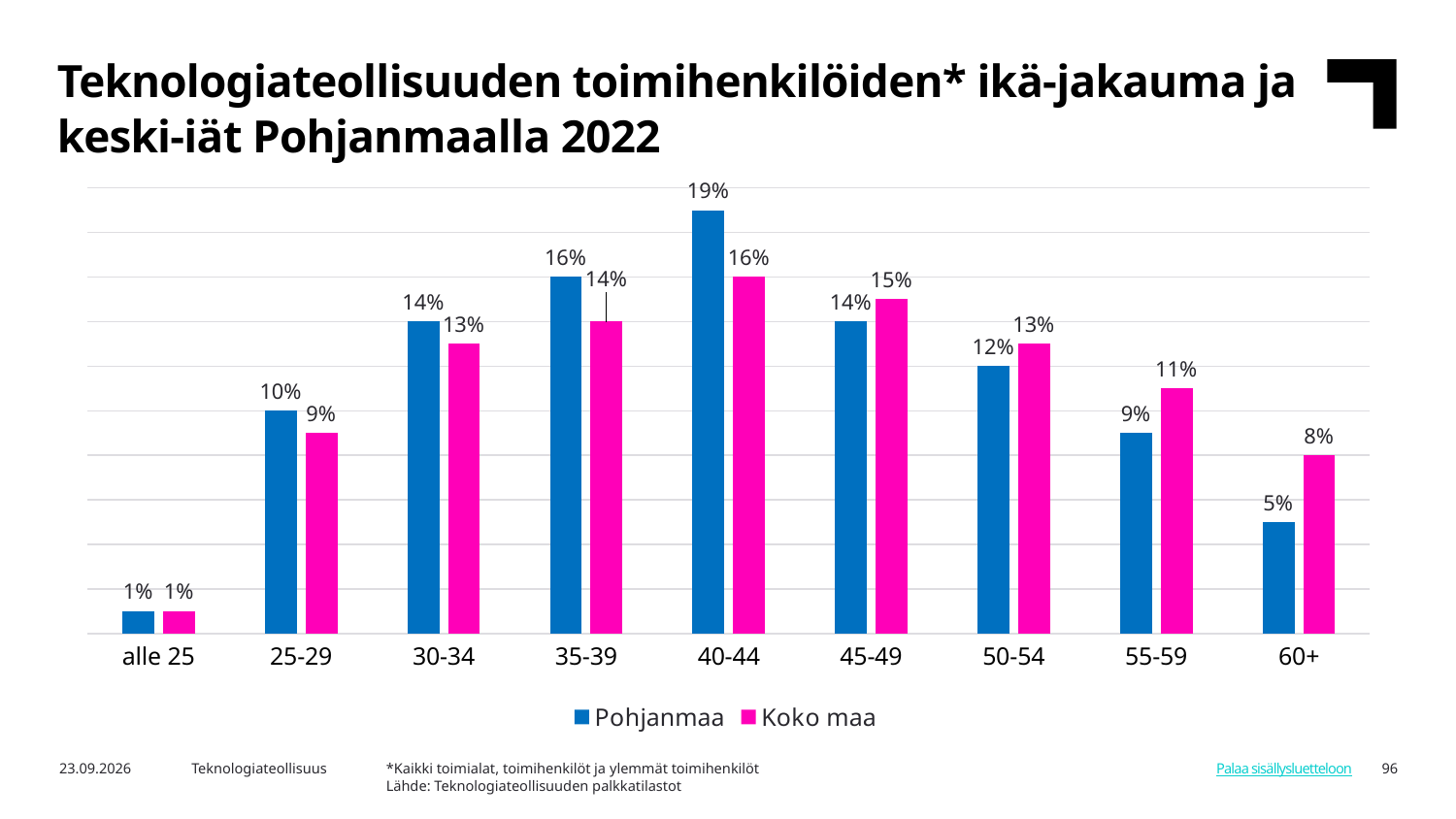
What is the value for Koko maa in the 55-59 age group? 11% Which age group has the highest value for Pohjanmaa? 40-44 What is the value for Pohjanmaa in the 60+ age group? 5% How many series does the legend list? 2 How many age groups are shown on the x axis? 9 Which age group has the lowest value for Koko maa? alle 25 What kind of chart is shown on the slide? Bar chart What is the value for Pohjanmaa in the 40-44 age group? 19% What is the difference between the Pohjanmaa values for 40-44 and 45-49? 5% What is the difference between Pohjanmaa and Koko maa in the 60+ age group? 3% Which series is shown in pink? Koko maa In the 45-49 age group, which series has the larger value, Pohjanmaa or Koko maa? Koko maa